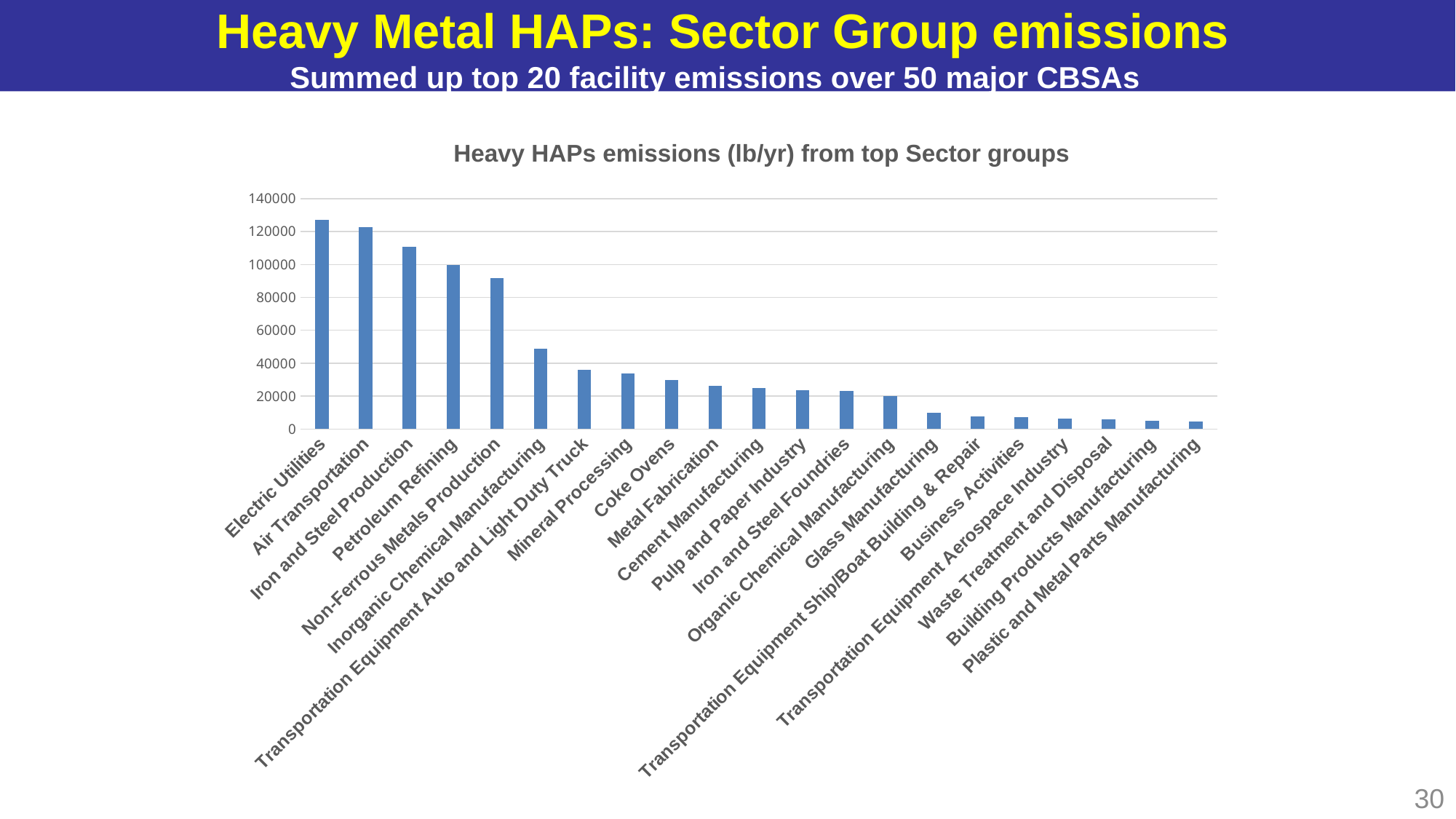
What is the title of the chart? Heavy HAPs emissions (lb/yr) from top Sector groups Which has higher emissions, Air Transportation or Coke Ovens? Air Transportation Is the value for Mineral Processing greater or less than 40000? less Is the value for Inorganic Chemical Manufacturing greater or less than 40000? greater Is the value for Glass Manufacturing greater or less than 20000? less Do the emission values rise or fall moving from left to right along the x axis? Fall What kind of chart is shown on the slide? Bar chart Which sector group has the highest emissions in the chart? Electric Utilities How many sector groups are plotted in the chart? 21